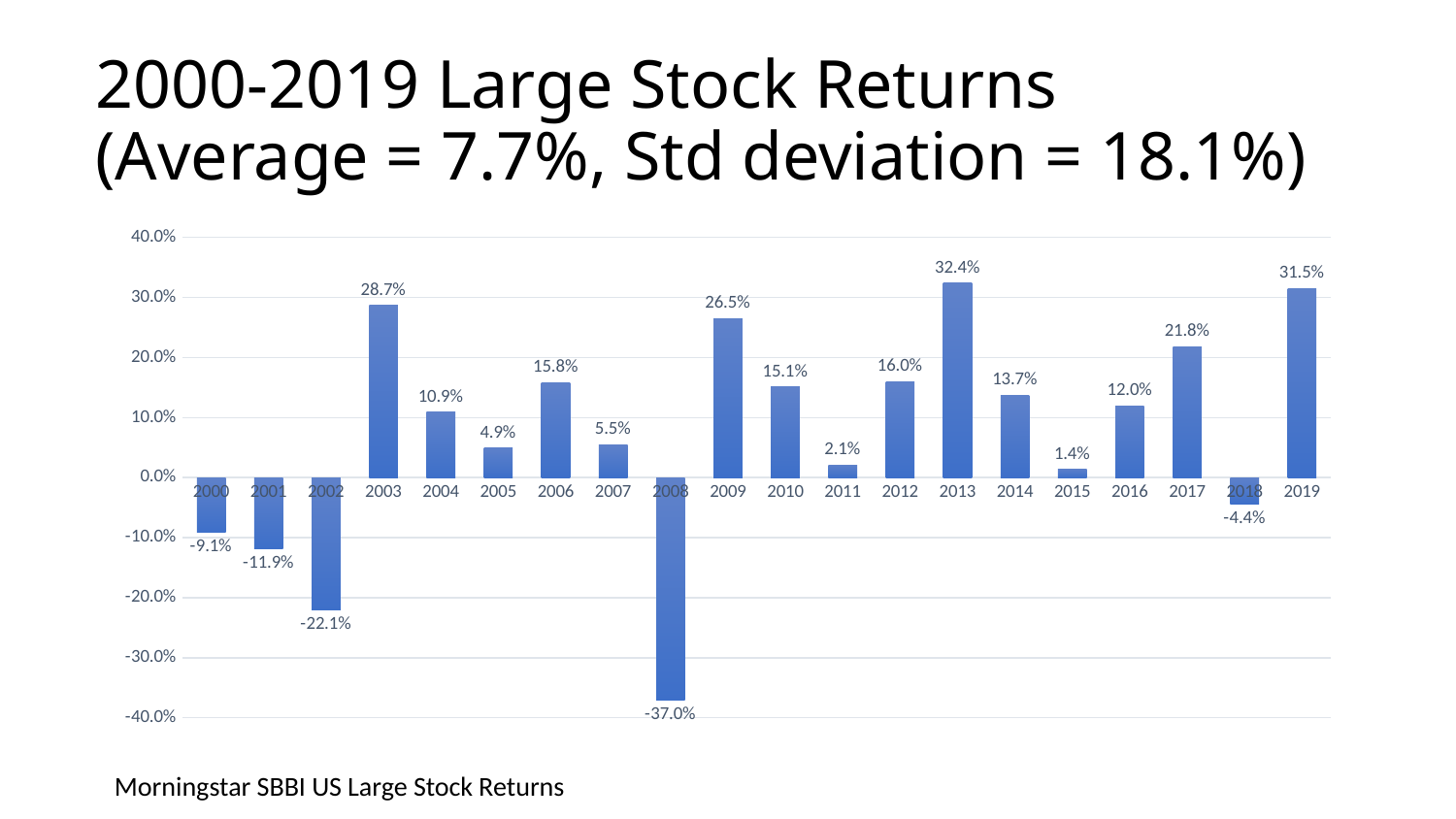
What was the large stock return in 2013? 32.4% How many years are shown on the chart? 20 What type of chart is shown on the slide? Bar chart What was the large stock return in 2008? -37.0% Did the returns rise or fall from 2000 to 2002? Fall Which year had the larger return, 2009 or 2017? 2009 What was the large stock return in 2018? -4.4% Which year had the highest large stock return? 2013 Which year had the lowest large stock return? 2008 What was the large stock return in 2019? 31.5% What is the source cited below the chart? Morningstar SBBI US Large Stock Returns What is the difference between the 2003 return and the 2004 return? 17.8%